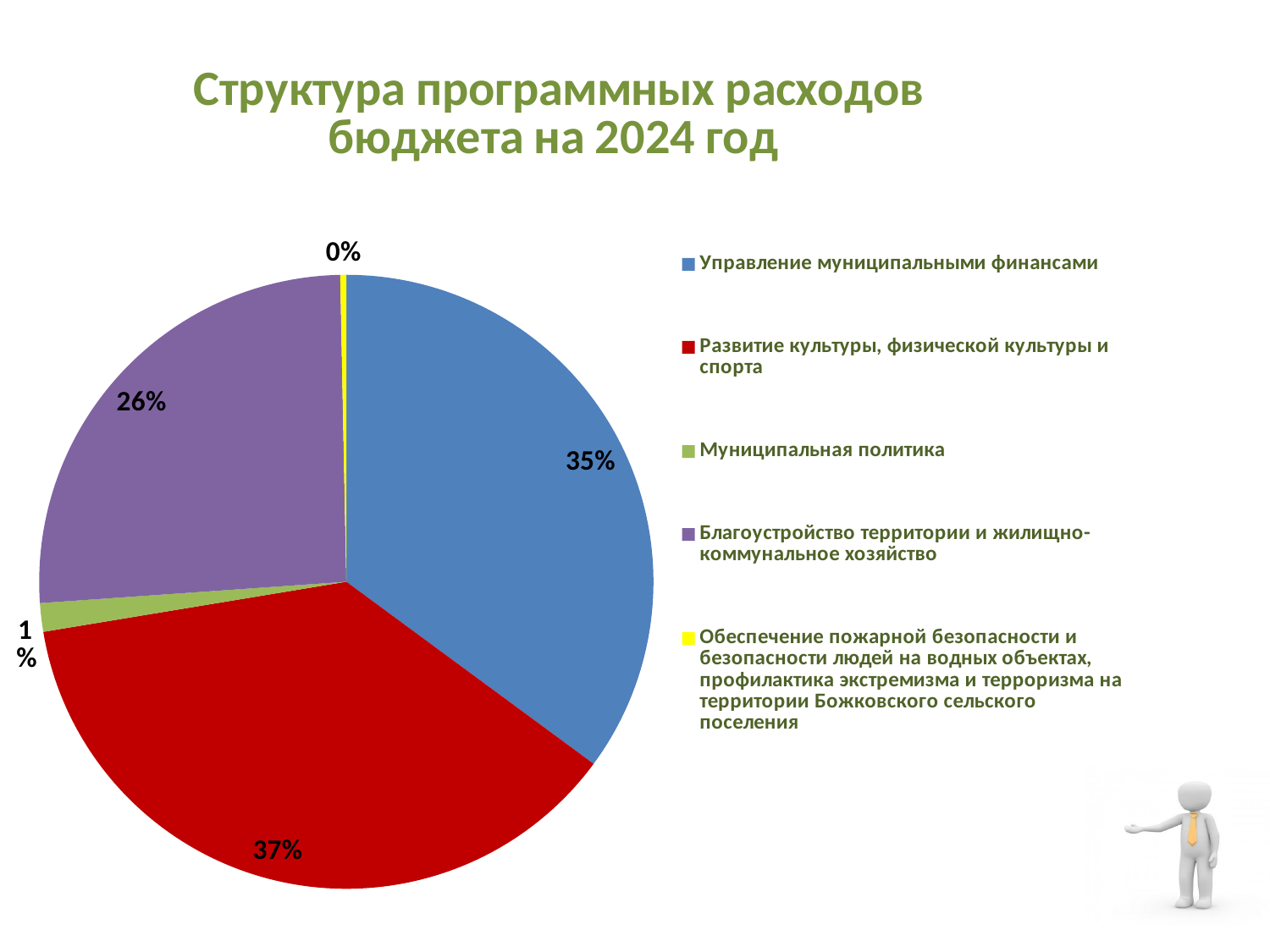
What is the share of the budget for Управление муниципальными финансами? 35% Which is larger: the share for Управление муниципальными финансами or the share for Благоустройство территории и жилищно-коммунальное хозяйство? Управление муниципальными финансами What is the difference in percentage points between Развитие культуры, физической культуры и спорта and Благоустройство территории и жилищно-коммунальное хозяйство? 11 percentage points Which category has the largest share of the budget? Развитие культуры, физической культуры и спорта What is the title of the chart? Структура программных расходов бюджета на 2024 год What is the share of the budget for Муниципальная политика? 1% What is the share of the budget for Развитие культуры, физической культуры и спорта? 37% What is the share of the budget for Благоустройство территории и жилищно-коммунальное хозяйство? 26% What type of chart is shown on the slide? Pie chart How many categories does the legend list? 5 What share is shown for Обеспечение пожарной безопасности и безопасности людей на водных объектах, профилактика экстремизма и терроризма на территории Божковского сельского поселения? 0% Which category has the smallest share of the budget? Обеспечение пожарной безопасности и безопасности людей на водных объектах, профилактика экстремизма и терроризма на территории Божковского сельского поселения